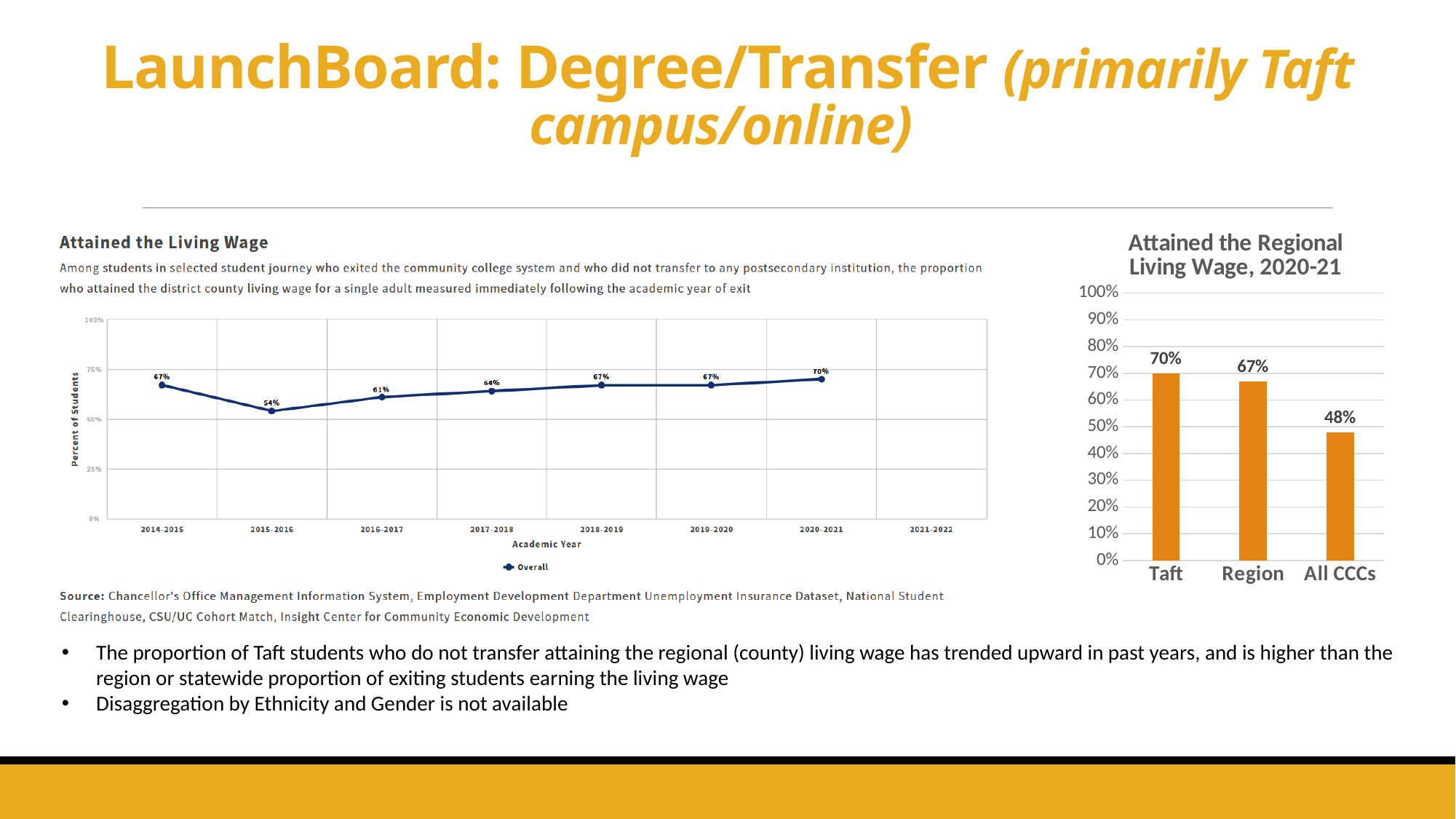
In the 'Attained the Living Wage' line chart, which academic year has the lowest value? 2015-2016 In the 'Attained the Regional Living Wage, 2020-21' chart, what is the value for All CCCs? 48% In the 'Attained the Living Wage' line chart, do the values rise or fall from 2015-2016 to 2020-2021? rise In the 'Attained the Regional Living Wage, 2020-21' chart, what kind of chart is shown? bar chart In the 'Attained the Living Wage' line chart, what series name is shown in the legend? Overall In the 'Attained the Regional Living Wage, 2020-21' chart, which category has the lowest value? All CCCs In the 'Attained the Living Wage' line chart, what is the value for 2015-2016? 54% In the 'Attained the Living Wage' line chart, what is the value for 2020-2021? 70% In the 'Attained the Regional Living Wage, 2020-21' chart, what is the difference between Taft and All CCCs? 22% In the 'Attained the Regional Living Wage, 2020-21' chart, how many categories are shown? 3 In the 'Attained the Regional Living Wage, 2020-21' chart, what is the value for Taft? 70% In the 'Attained the Living Wage' line chart, what is the difference between the 2020-2021 value and the 2015-2016 value? 16%